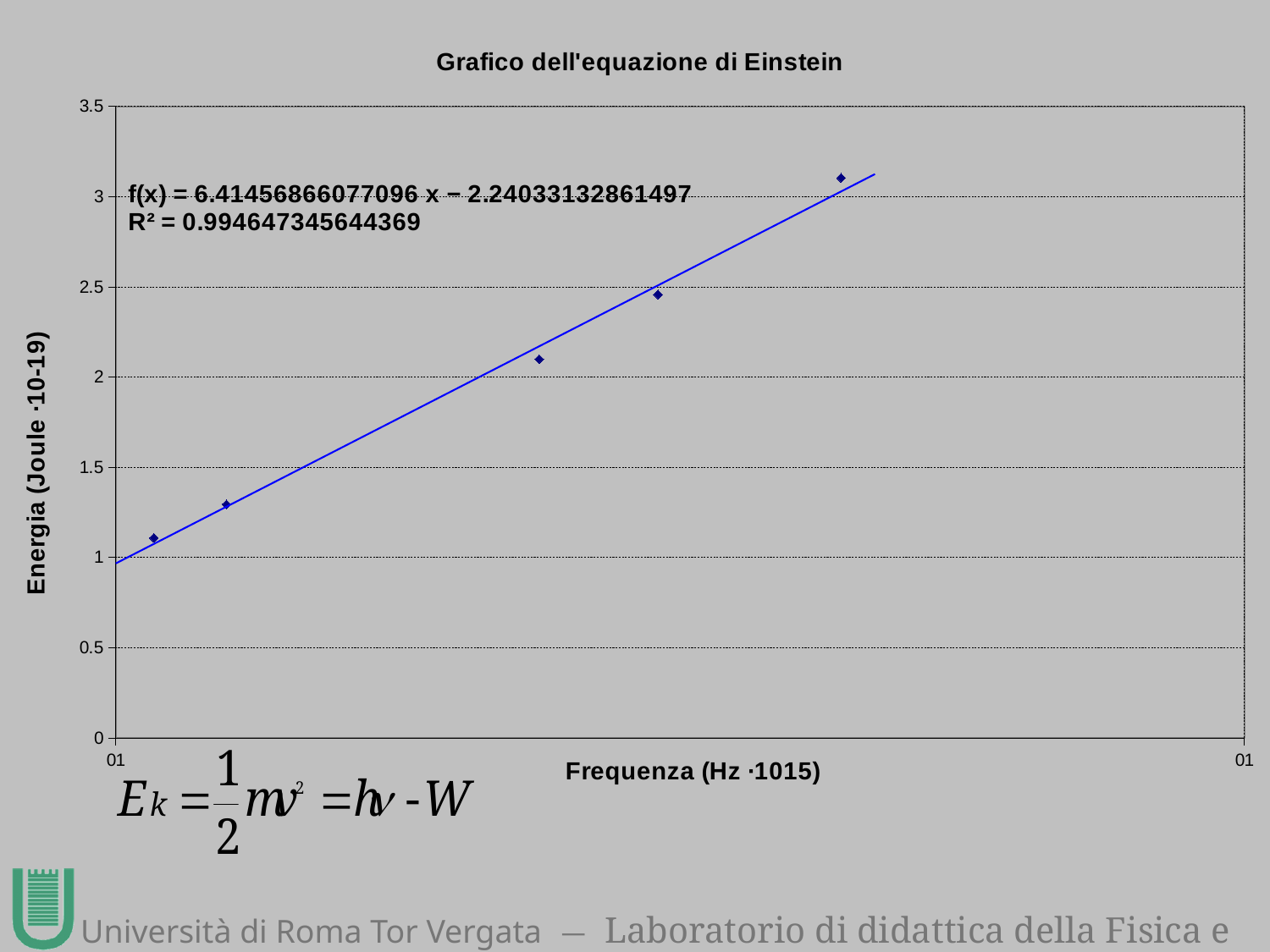
What kind of chart is shown on the slide? scatter chart What is the slope of the fitted line f(x) printed on the chart? 6.41456866077096 Is the energy value of the lowest data point greater or less than 1.5? less What is the intercept of the fitted line f(x) printed on the chart? −2.24033132861497 What R² value is printed on the chart for the fitted line? 0.994647345644369 Do the plotted energy values rise or fall as frequency increases along the x axis? rise What is the label of the y axis? Energia (Joule ·10-19) What is the title of the chart? Grafico dell'equazione di Einstein How many data points are plotted on the chart? 5 Is the energy value of the lowest data point greater or less than 1? greater Is the energy value of the second-lowest data point greater or less than 1.5? less